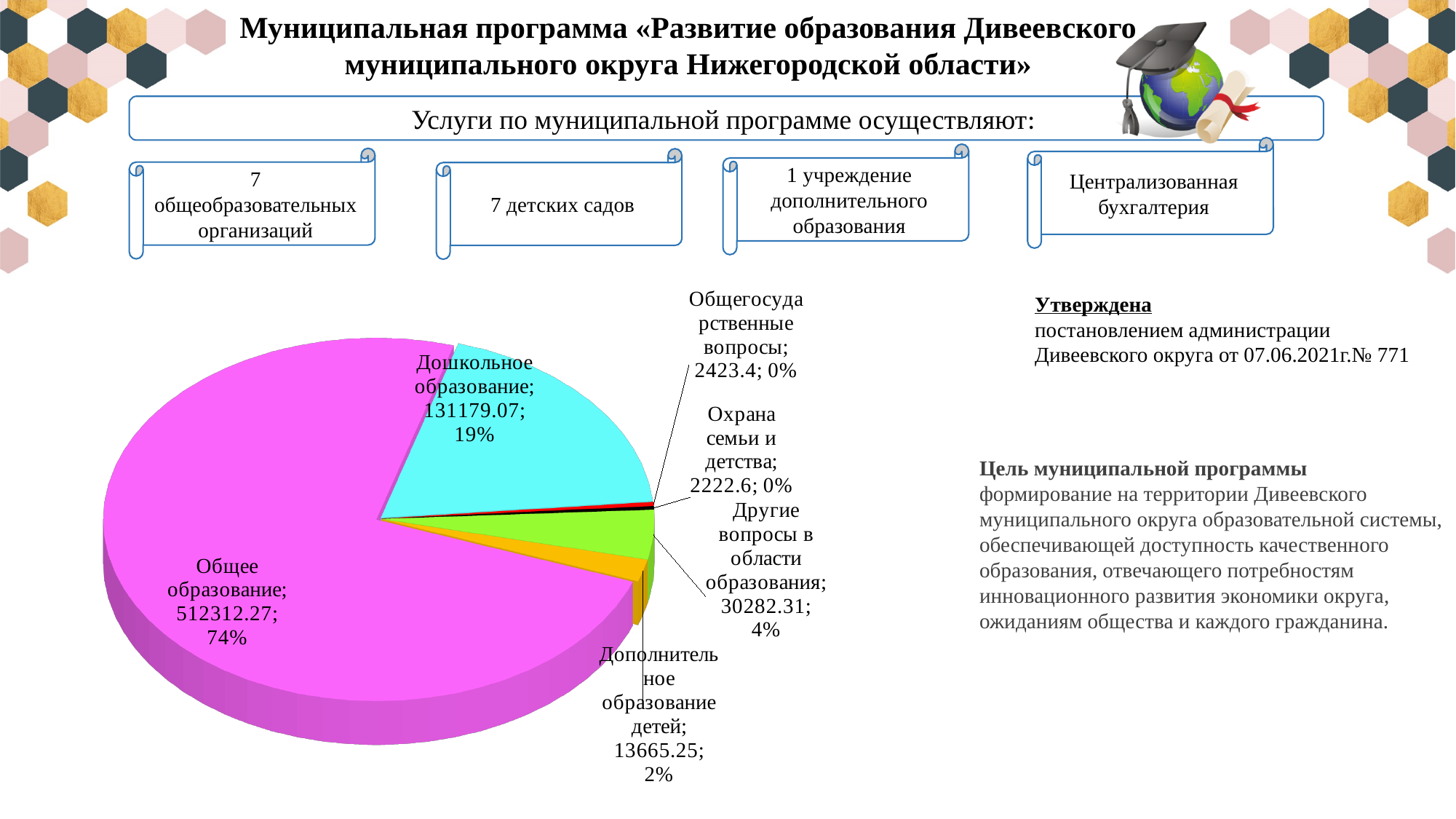
What value is shown for the "Дополнительное образование детей" slice? 13665.25 Which is larger: the value for "Общегосударственные вопросы" or for "Охрана семьи и детства"? Общегосударственные вопросы What value is shown for the "Общее образование" slice of the pie chart? 512312.27 What value is shown for the "Дошкольное образование" slice of the pie chart? 131179.07 Which category has the largest slice in the pie chart? Общее образование What kind of chart is shown on the slide? Pie chart Which category has the smallest value in the pie chart? Охрана семьи и детства What value is shown for the "Другие вопросы в области образования" slice? 30282.31 What share of the pie does "Общее образование" represent? 74% What is the difference between the values for "Общее образование" and "Дошкольное образование"? 381133.2 How many slices does the pie chart have? 6 What share of the pie does "Дошкольное образование" represent? 19%